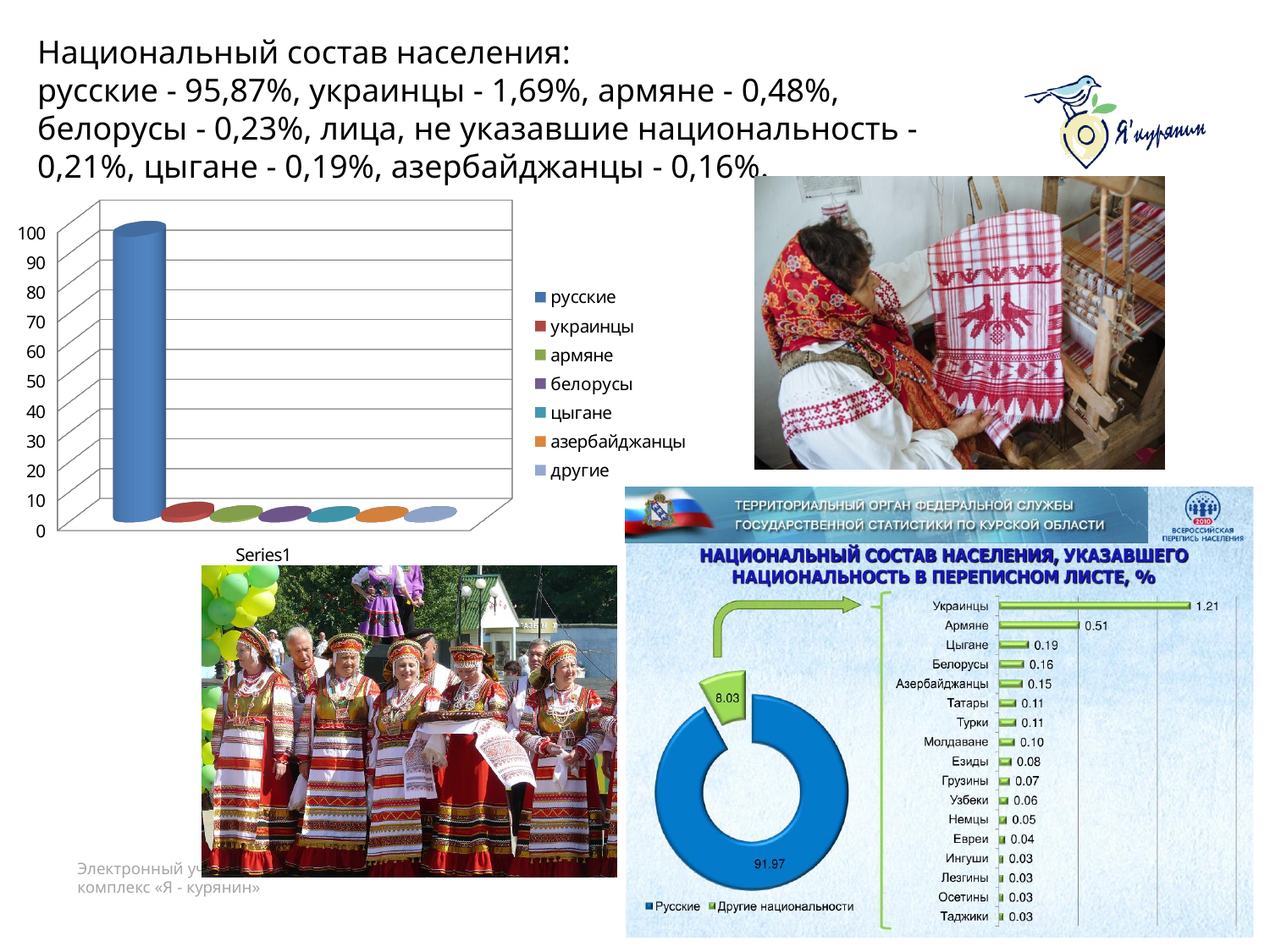
In the bar chart on the left, is the value for украинцы greater or less than 10? less In the chart titled 'Национальный состав населения, указавшего национальность в переписном листе, %', what is the value for Армяне? 0.51 In the donut chart titled 'Национальный состав населения, указавшего национальность в переписном листе, %', what share is shown for Русские? 91.97 In the chart titled 'Национальный состав населения, указавшего национальность в переписном листе, %', which is larger: the value for Цыгане or for Белорусы? Цыгане In the bar chart on the left, which category has the tallest bar? русские In the chart titled 'Национальный состав населения, указавшего национальность в переписном листе, %', what is the difference between the values for Украинцы and Армяне? 0.70 In the chart titled 'Национальный состав населения, указавшего национальность в переписном листе, %', what is the value for Украинцы? 1.21 What kind of chart is the chart on the left side of the slide? bar chart What is the last entry in the legend of the bar chart on the left? другие How many entries does the legend of the bar chart on the left list? 7 In the bar chart on the left, is the value for русские greater or less than 90? greater In the chart titled 'Национальный состав населения, указавшего национальность в переписном листе, %', which nationality in the horizontal bar list has the highest value? Украинцы